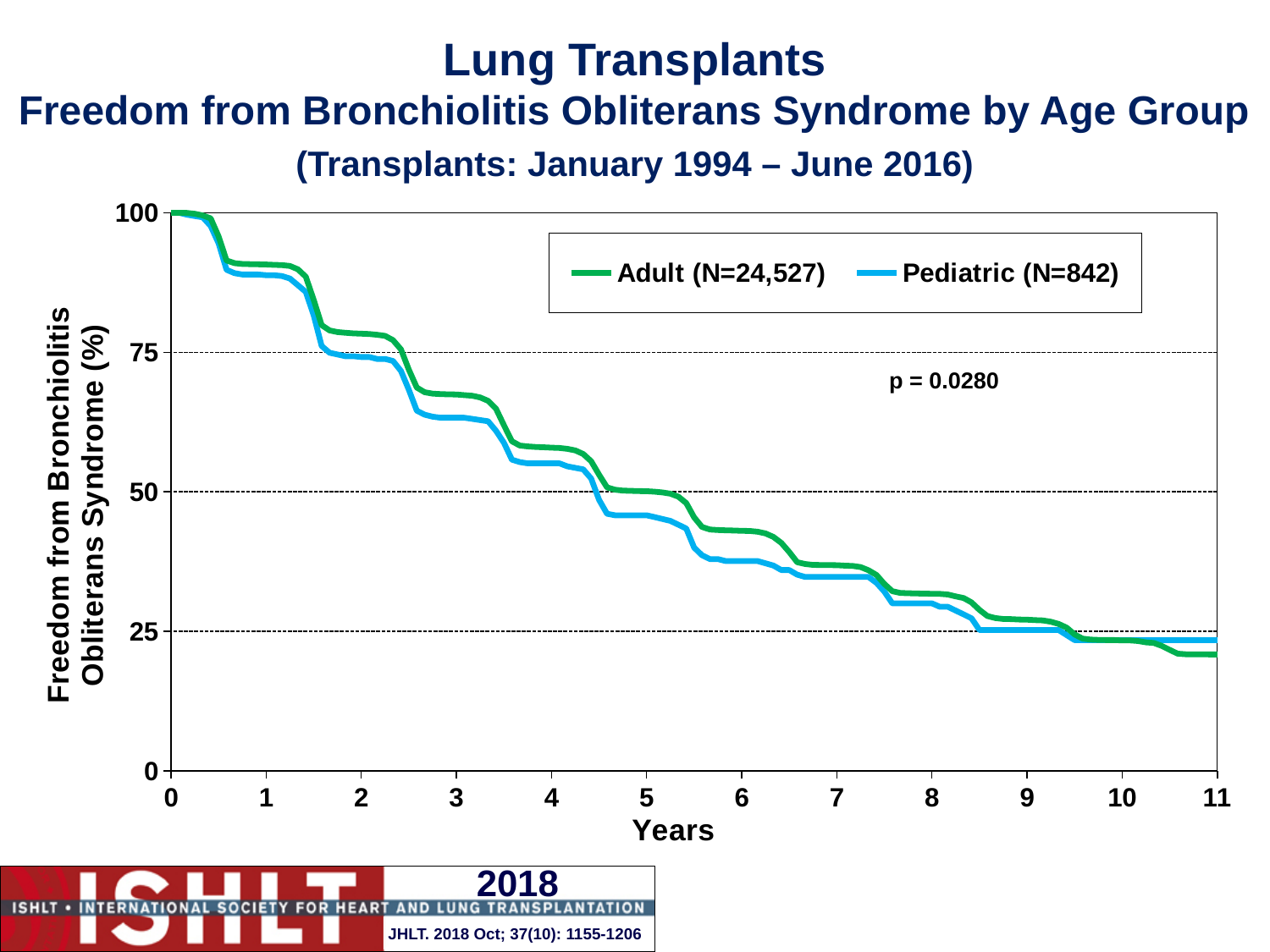
How many series does the legend list? 2 What is the N for the Pediatric series according to the legend? 842 What is the highest value shown on the x axis (Years)? 11 Is the value for the Adult series at year 8 greater or less than 25? greater Is the value for the Adult series at year 3 greater or less than 75? less At year 3, which series has the higher freedom from bronchiolitis obliterans syndrome, Adult or Pediatric? Adult Is the value for the Pediatric series at year 5 greater or less than 50? less Do the values for the Adult series rise or fall as years increase? Fall What kind of chart is shown on the slide? Line chart What p value is printed on the chart? p = 0.0280